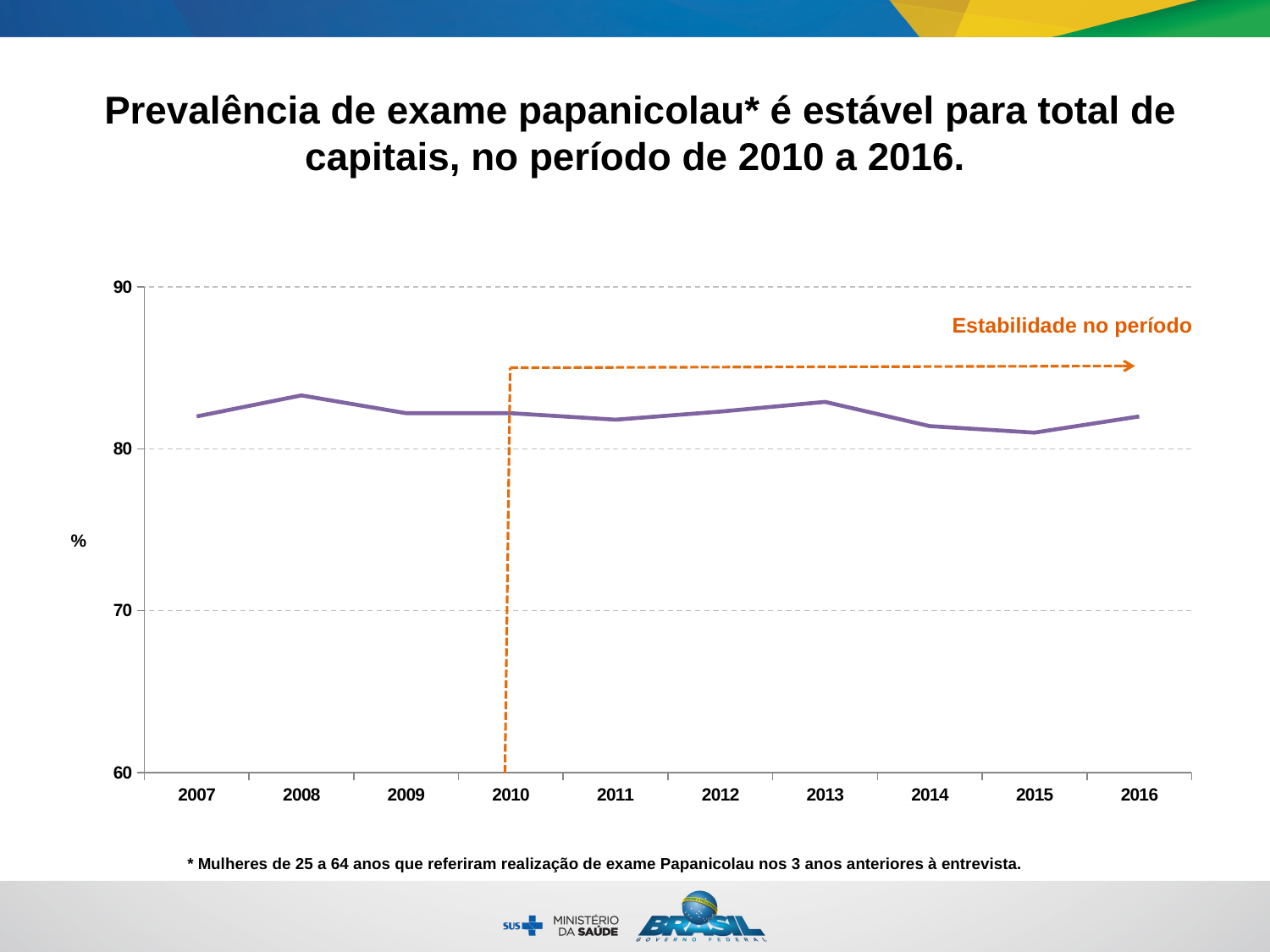
Is the value for 2015 greater or less than 80? greater How many years are plotted along the x axis? 10 Is the value for 2012 greater or less than 70? greater What text is written in orange above the dashed arrow? Estabilidade no período Is the value for 2008 greater or less than 90? less Which is larger, the value for 2013 or the value for 2011? 2013 Does the line rise or fall from 2013 to 2015? fall What kind of chart is shown on the slide? line chart What is the first year shown on the x axis? 2007 Which year has the lowest plotted value? 2015 Which is larger, the value for 2008 or the value for 2015? 2008